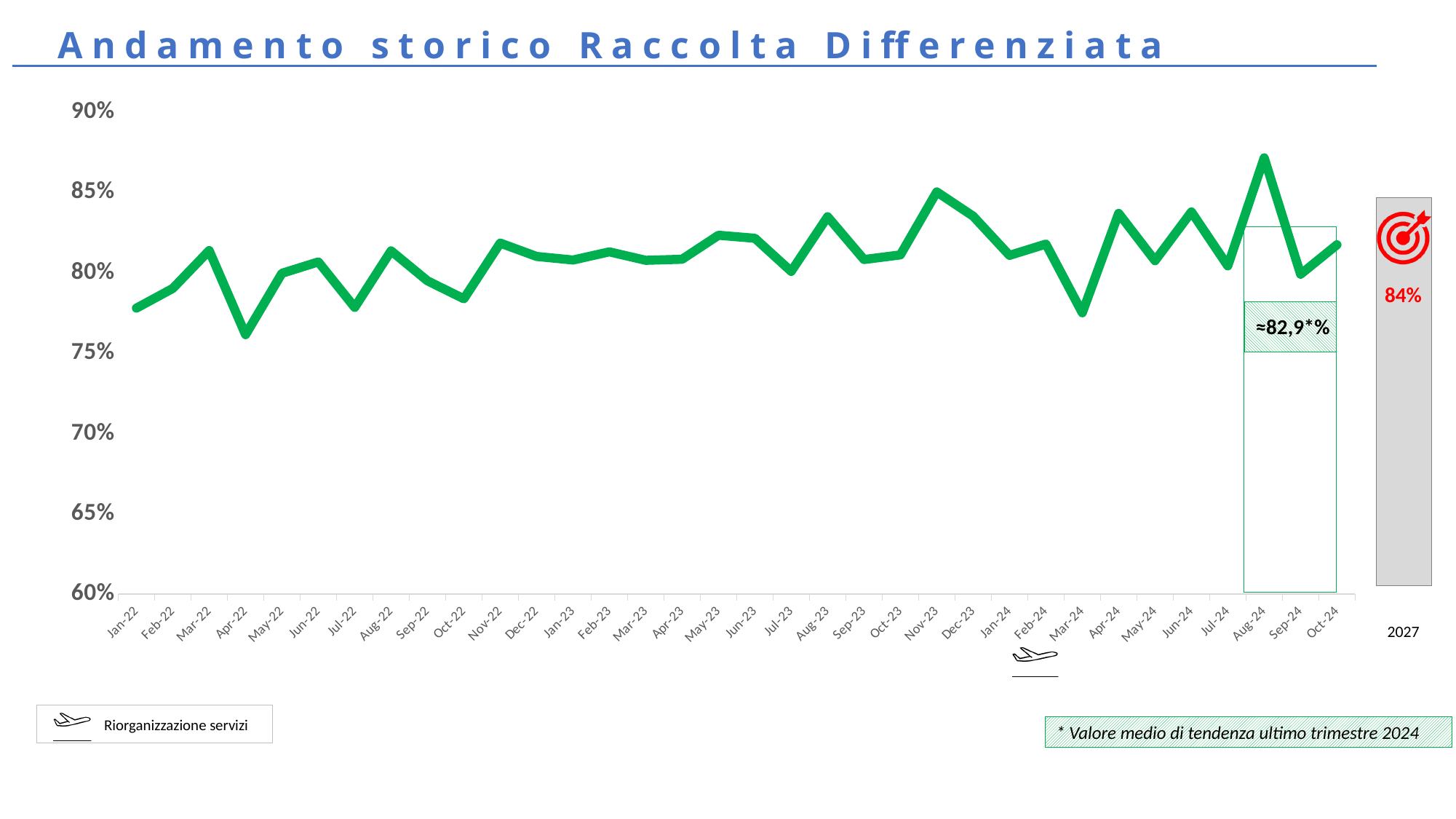
Which month has the highest value on the line? Aug-24 What kind of chart is shown on the slide? line chart What does the airplane icon below the x axis indicate, according to the legend box? Riorganizzazione servizi How many monthly data points are plotted on the line, from Jan-22 to Oct-24? 34 Is the value for Apr-22 greater or less than 80%? less What is the title of the chart? Andamento storico Raccolta Differenziata Is the value for Aug-24 greater or less than 85%? greater Which month has the lowest value on the line? Apr-22 What target value is shown for 2027? 84% Which is larger, the value for Aug-24 or the value for Mar-24? Aug-24 What value is printed in the hatched box for the average trend of the last quarter of 2024? ≈82,9*% Is the value for Nov-23 greater or less than 80%? greater